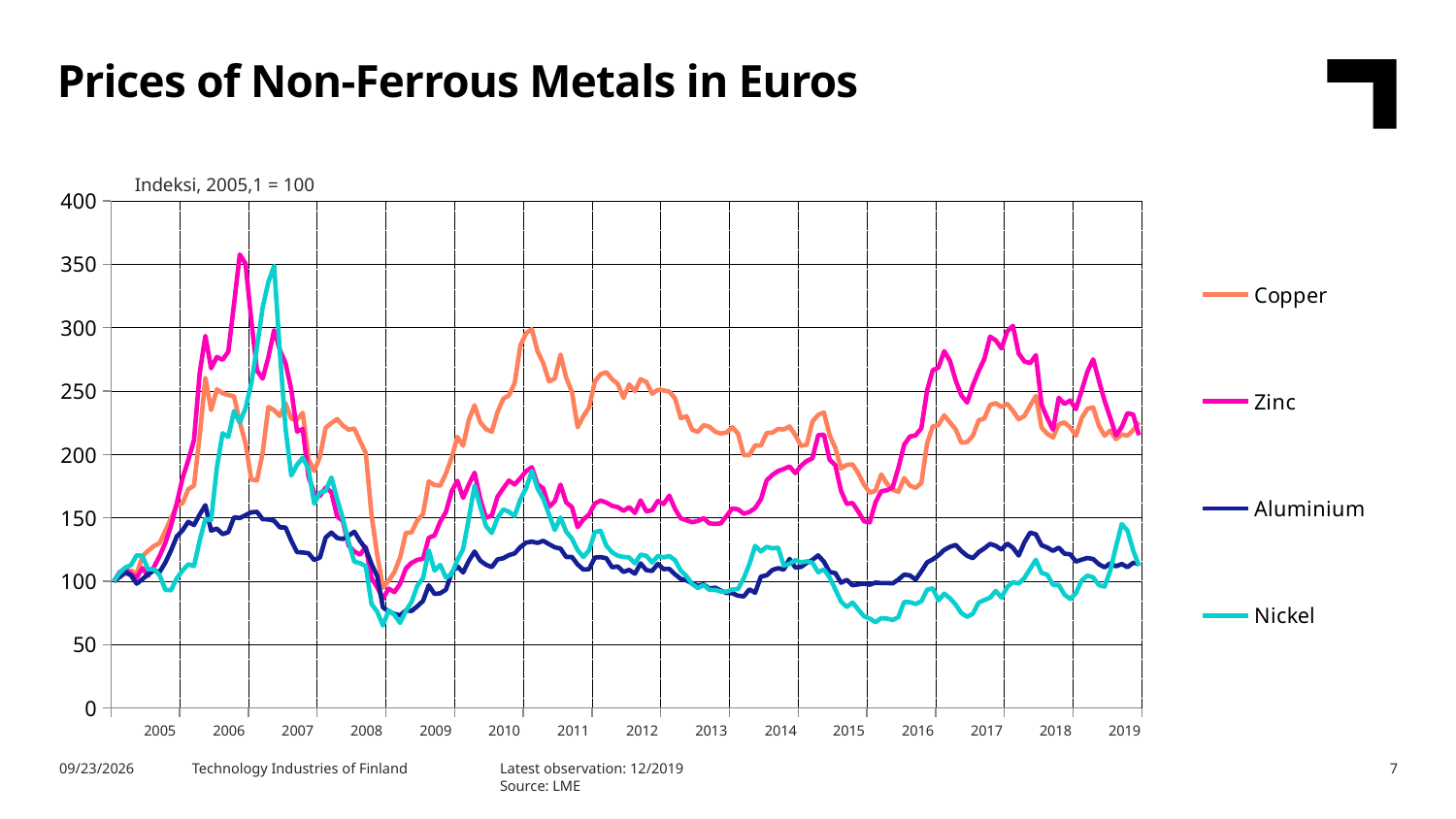
How many series does the legend list? 4 Which series has the lowest index value during 2016? Nickel What is the index base stated above the chart? Indeksi, 2005,1 = 100 What kind of chart is shown on the slide? Line chart At the end of 2019, which is higher: Copper or Aluminium? Copper Is the Aluminium index at the end of 2019 greater or less than 150? less Is the Nickel peak in 2006 greater or less than 300? less Which series has the highest index value during 2012? Copper Does the Copper index rise or fall from 2011 to 2015? Fall Is the Nickel index in early 2016 greater or less than 100? less Which metals are listed in the chart legend? Copper, Zinc, Aluminium, Nickel